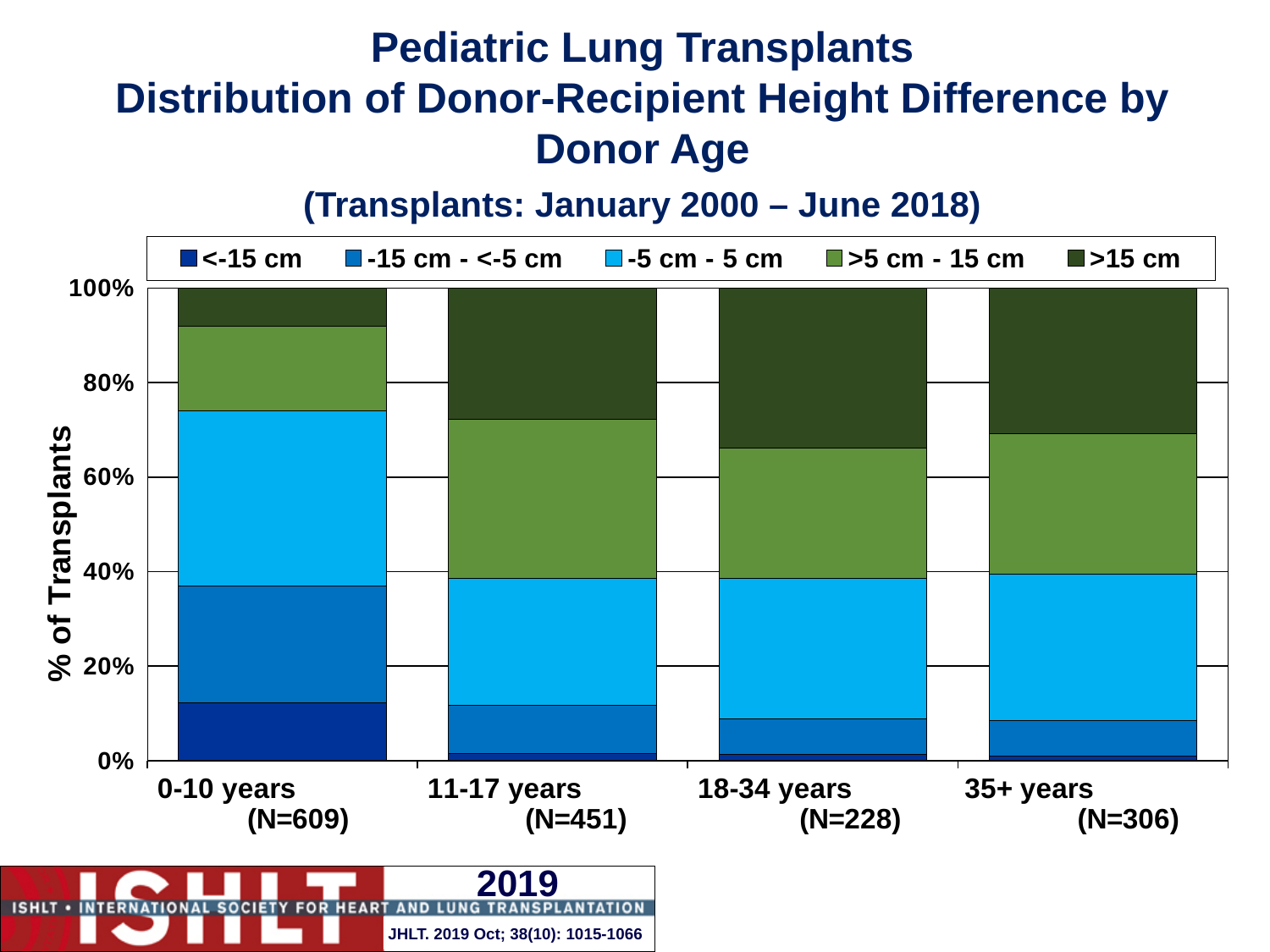
Which donor age group has the largest share of transplants in the -5 cm - 5 cm category? 0-10 years What is the N shown for the 0-10 years donor age group? N=609 Which donor age group has the smallest share of transplants in the >15 cm category? 0-10 years Is the share of the >15 cm category larger for 0-10 years or for 11-17 years? 11-17 years Which donor age group has the largest share of transplants in the <-15 cm category? 0-10 years What transplant date range is given in the chart title? January 2000 – June 2018 Is the share of the <-15 cm category larger for 0-10 years or for 11-17 years? 0-10 years Does the share of the >15 cm category rise or fall from the 0-10 years group to the 11-17 years group? rise How many height-difference categories does the legend list? 5 How many donor age groups are shown on the x axis? 4 For the 0-10 years group, is the combined share of the <-15 cm, -15 cm - <-5 cm and -5 cm - 5 cm categories greater or less than 60%? greater What kind of chart is shown on the slide? Stacked bar chart